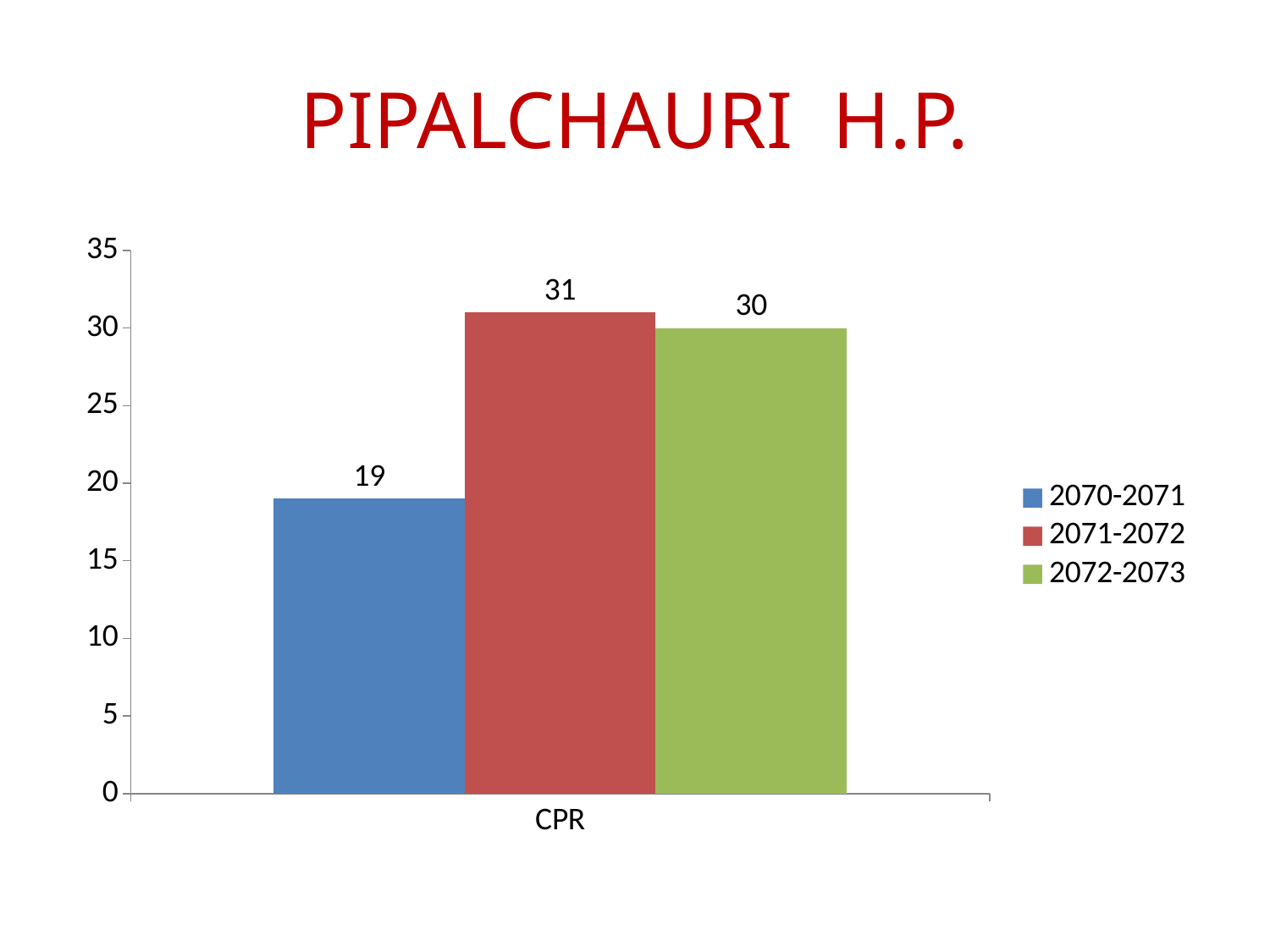
What is the CPR value for 2071-2072? 31 What is the CPR value for 2070-2071? 19 What kind of chart is shown on the slide? bar chart What is the difference between the CPR values for 2072-2073 and 2070-2071? 11 Which year has the highest CPR value? 2071-2072 What is the CPR value for 2072-2073? 30 Which is larger, the CPR value for 2070-2071 or for 2072-2073? 2072-2073 What is the title of the slide? PIPALCHAURI H.P. Is the CPR value for 2070-2071 greater or less than 20? less Which year has the lowest CPR value? 2070-2071 How many series does the legend list? 3 What is the difference between the CPR values for 2071-2072 and 2070-2071? 12